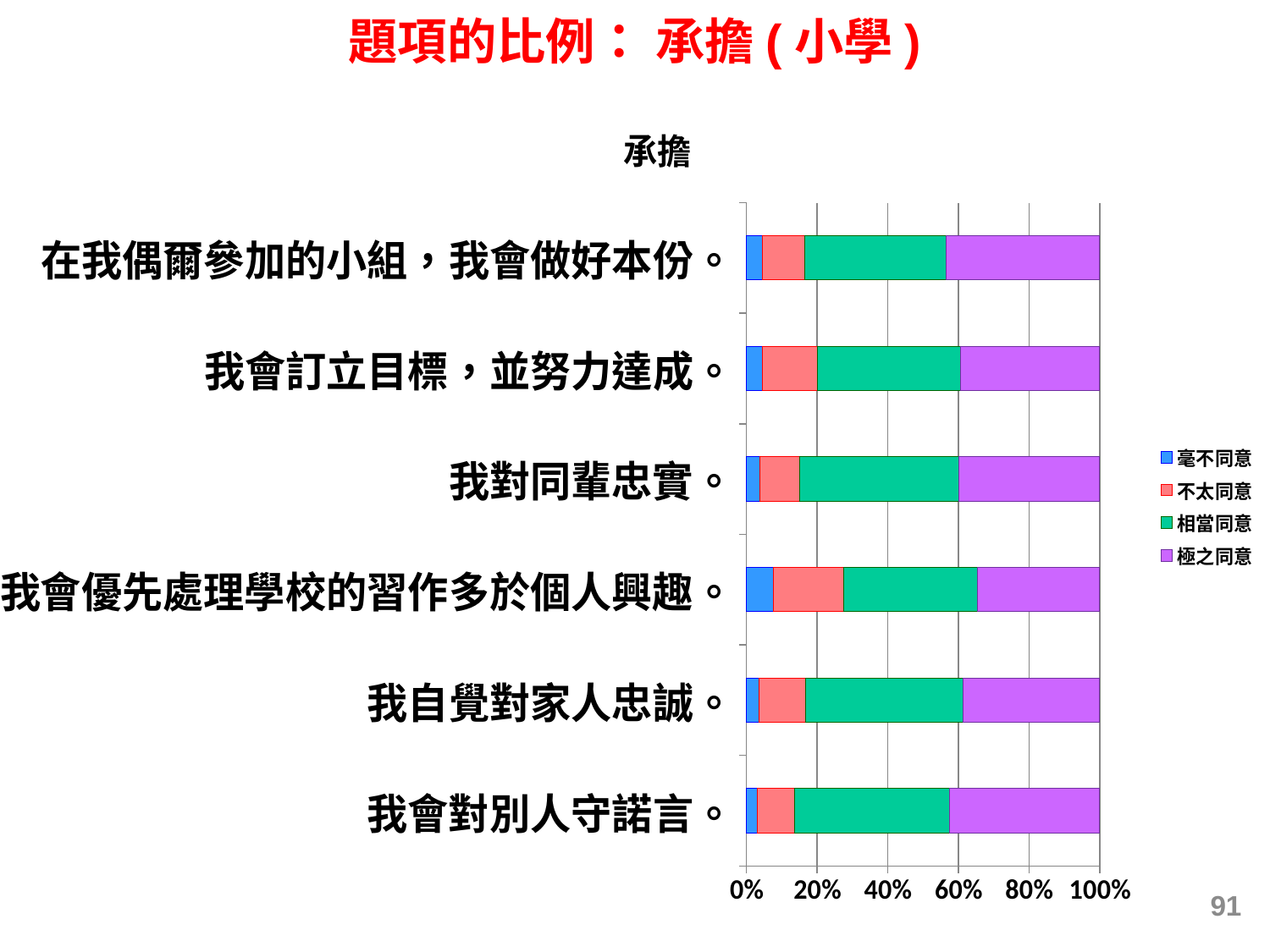
What is the title shown above the chart? 承擔 Which has the larger 毫不同意 segment: 我會優先處理學校的習作多於個人興趣 or 我會對別人守諾言? 我會優先處理學校的習作多於個人興趣。 Is the combined share of 毫不同意 and 不太同意 for 我會優先處理學校的習作多於個人興趣 greater or less than 20%? greater Which legend entry is shown in purple? 極之同意 Is the combined share of 毫不同意 and 不太同意 for 在我偶爾參加的小組，我會做好本份 greater or less than 20%? less Which item has the largest 毫不同意 segment? 我會優先處理學校的習作多於個人興趣。 What kind of chart is shown on the slide? Stacked bar chart Is the combined share of 毫不同意 and 不太同意 for 我對同輩忠實 greater or less than 20%? less What does each stacked bar total at its right end on the axis? 100% How many series does the legend list? 4 Which item has the largest 不太同意 segment? 我會優先處理學校的習作多於個人興趣。 How many items (categories) are plotted in the chart? 6